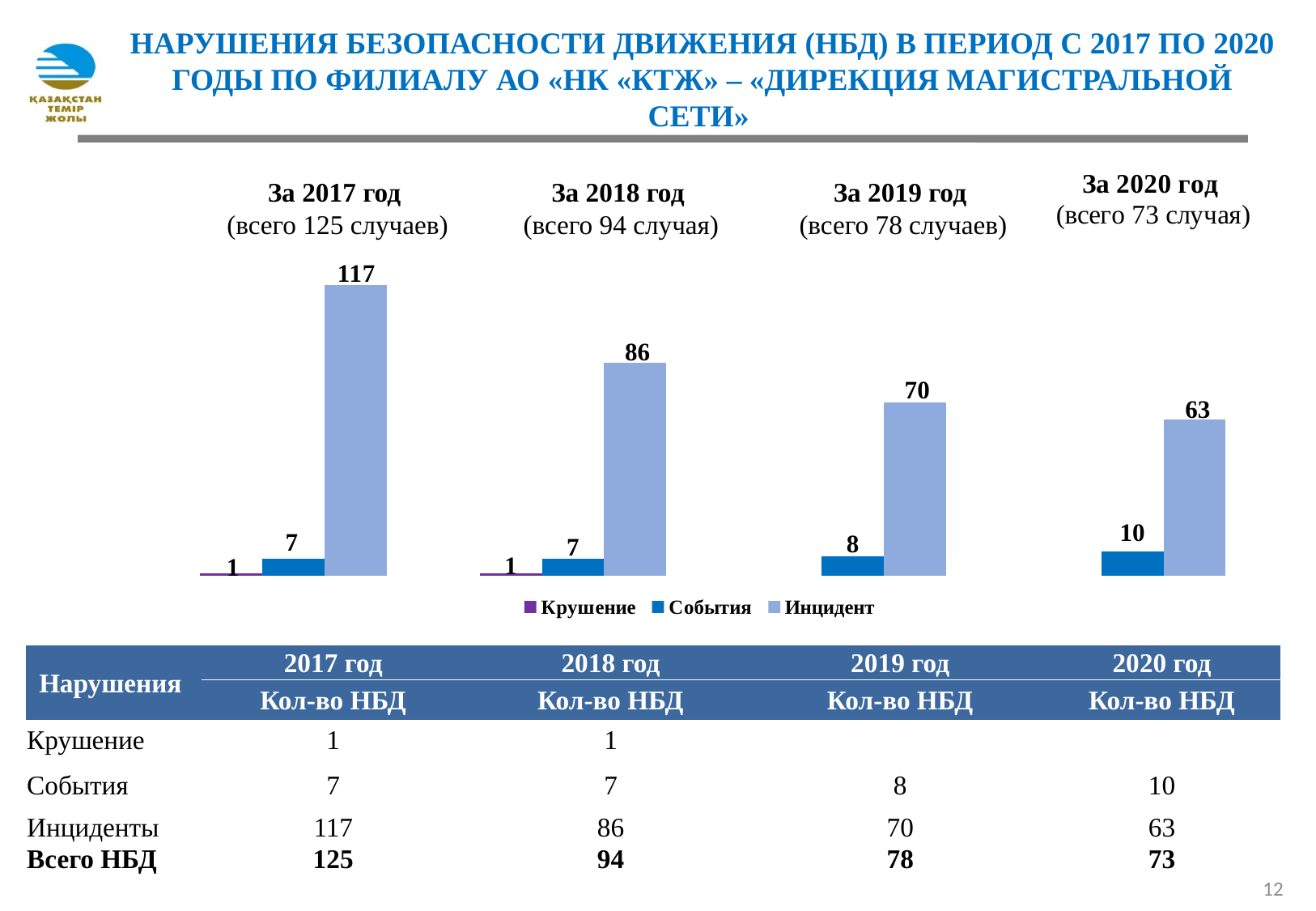
In which year is the Инцидент value lowest? 2020 What is the value of Инцидент for 2017 (За 2017 год)? 117 Which series is shown in purple in the chart legend? Крушение Which is larger: the События value for 2019 or for 2020? 2020 Does the Инцидент value rise or fall from 2017 to 2020? fall What type of chart is shown on the slide? bar chart What is the difference between the Инцидент values for 2017 and 2018? 31 In which year is the Инцидент value highest? 2017 What is the value of События for 2020 (За 2020 год)? 10 How many series does the chart legend list? 3 How many year groups are shown on the chart? 4 What is the value of Инцидент for 2019 (За 2019 год)? 70